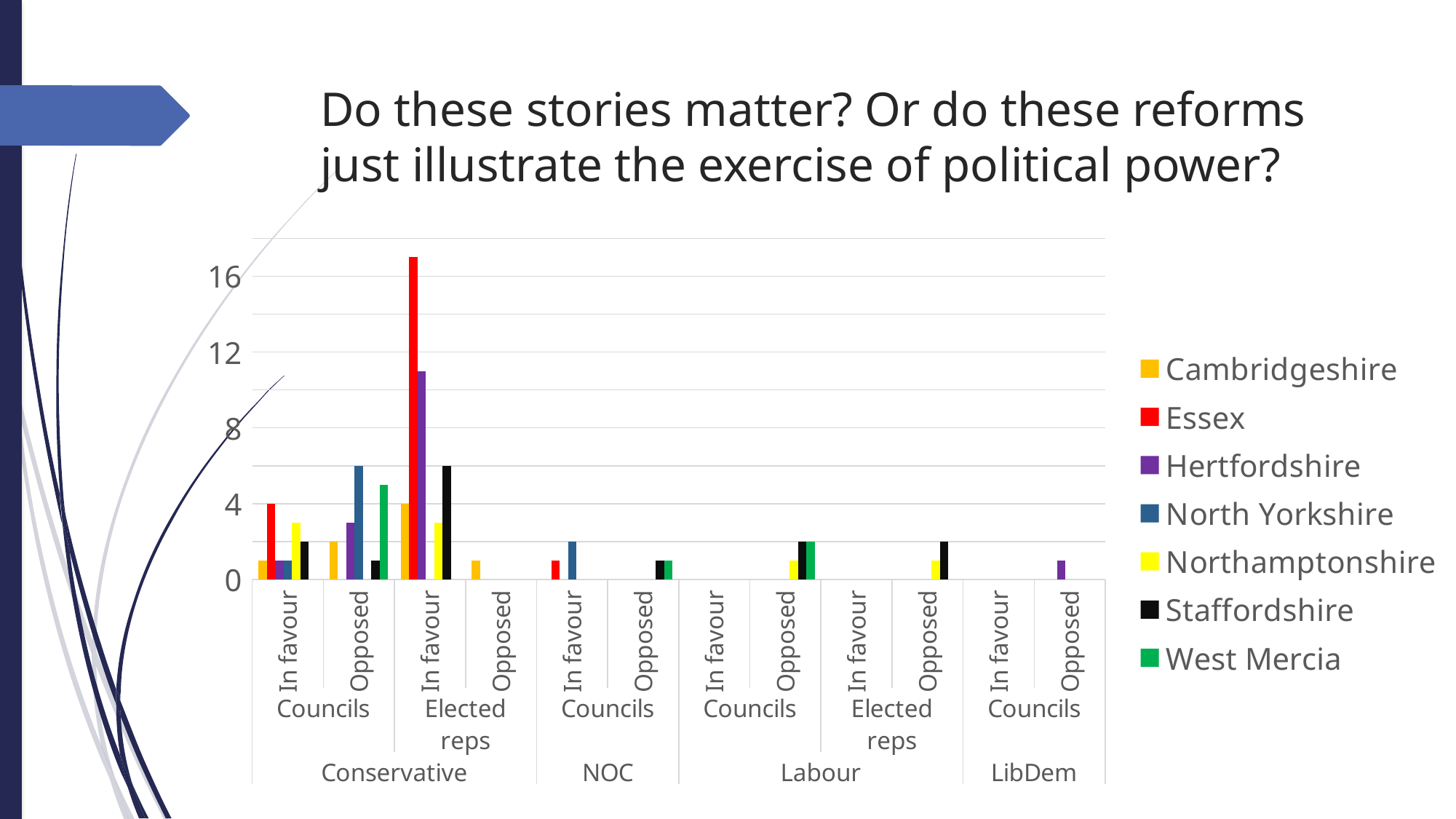
Is the value for Hertfordshire in the Conservative Elected reps 'In favour' group greater or less than 8? greater Which series has the highest bar in the chart? Essex Is the value for North Yorkshire in the Conservative Councils 'Opposed' group greater or less than 4? greater What kind of chart is shown on the slide? bar chart In the Conservative Elected reps 'In favour' group, which is larger: Essex or Hertfordshire? Essex How many series does the legend list? 7 Is the value for Essex in the Conservative Elected reps 'In favour' group greater or less than 16? greater How many party groups are shown along the x axis? 4 What is the value for Cambridgeshire in the Conservative Elected reps 'In favour' group? 4 What is the value for Essex in the Conservative Councils 'In favour' group? 4 Which series is shown in red in the legend? Essex